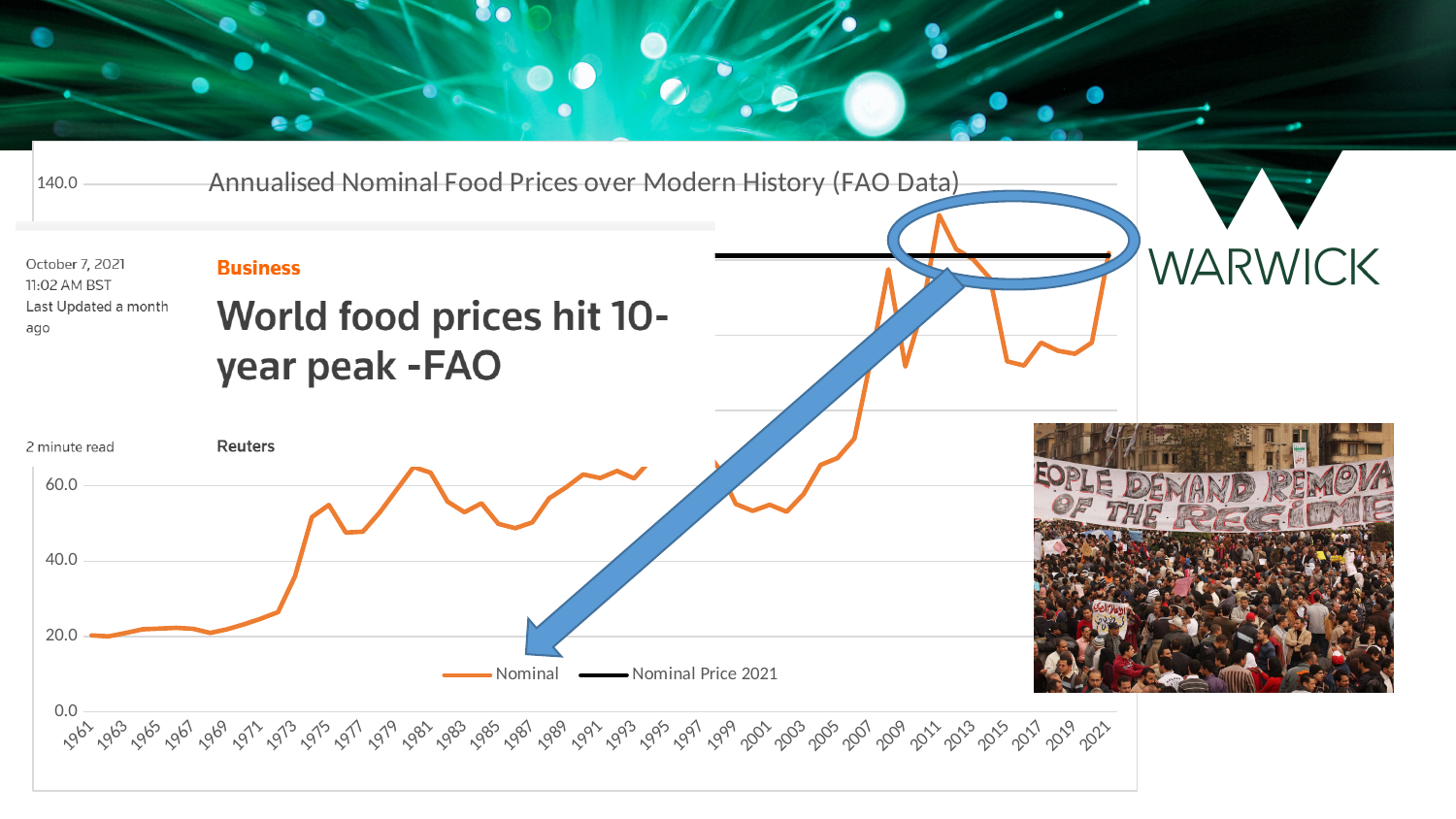
What kind of chart is shown on the slide? line chart How many year labels are shown on the x axis? 31 What colour is the Nominal series line? orange What is the title of the chart? Annualised Nominal Food Prices over Modern History (FAO Data) Is the Nominal value for 1973 greater or less than 40? less Is the Nominal value for 1975 greater or less than 40? greater Is the peak Nominal value around 2011 greater or less than 140? less How many series does the chart legend list? 2 Do the Nominal values rise or fall from 1961 to 1975? rise Which is larger, the Nominal value for 2011 or for 1981? 2011 Which is larger, the Nominal value for 1975 or for 1961? 1975